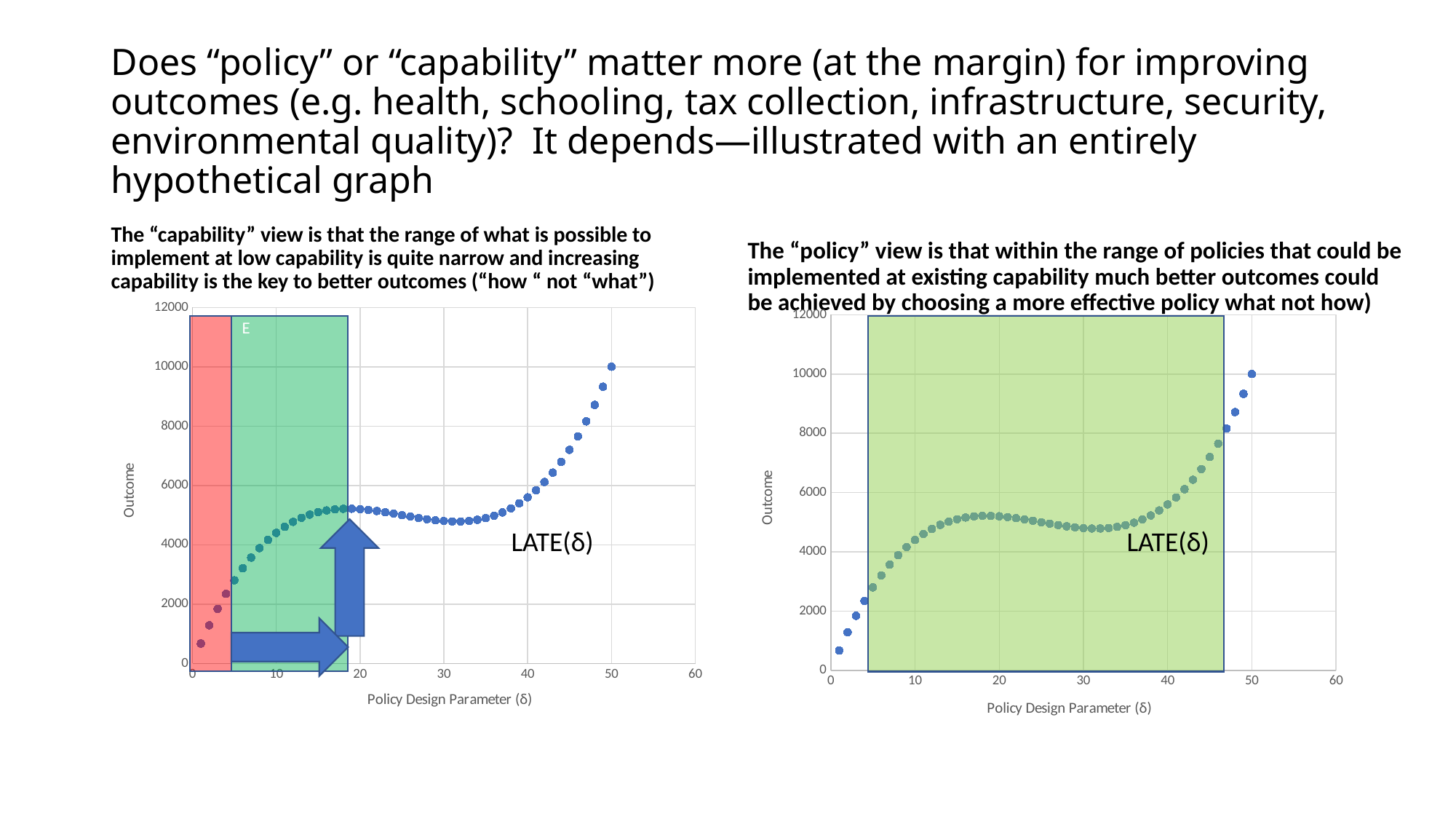
On the right chart, is the Outcome at a Policy Design Parameter of 40 greater or less than 8000? less On the right chart, is the Outcome at a Policy Design Parameter of 30 greater or less than 6000? less On the left chart, is the Outcome higher at a Policy Design Parameter of 20 or at 30? 20 On the right chart, what is the title of the y axis? Outcome On the right chart, what is the highest value shown on the y axis? 12000 What kind of chart is the left chart (under the "capability" view text)? scatter chart On the left chart, is the Outcome at a Policy Design Parameter of 10 greater or less than 2000? greater On the left chart, what is the title of the x axis? Policy Design Parameter (δ) On the right chart, at which value of the Policy Design Parameter is the Outcome highest? 50 On the left chart, do the Outcome values rise or fall as the Policy Design Parameter increases from 20 to 30? fall On the right chart, do the Outcome values rise or fall as the Policy Design Parameter increases from 30 to 50? rise